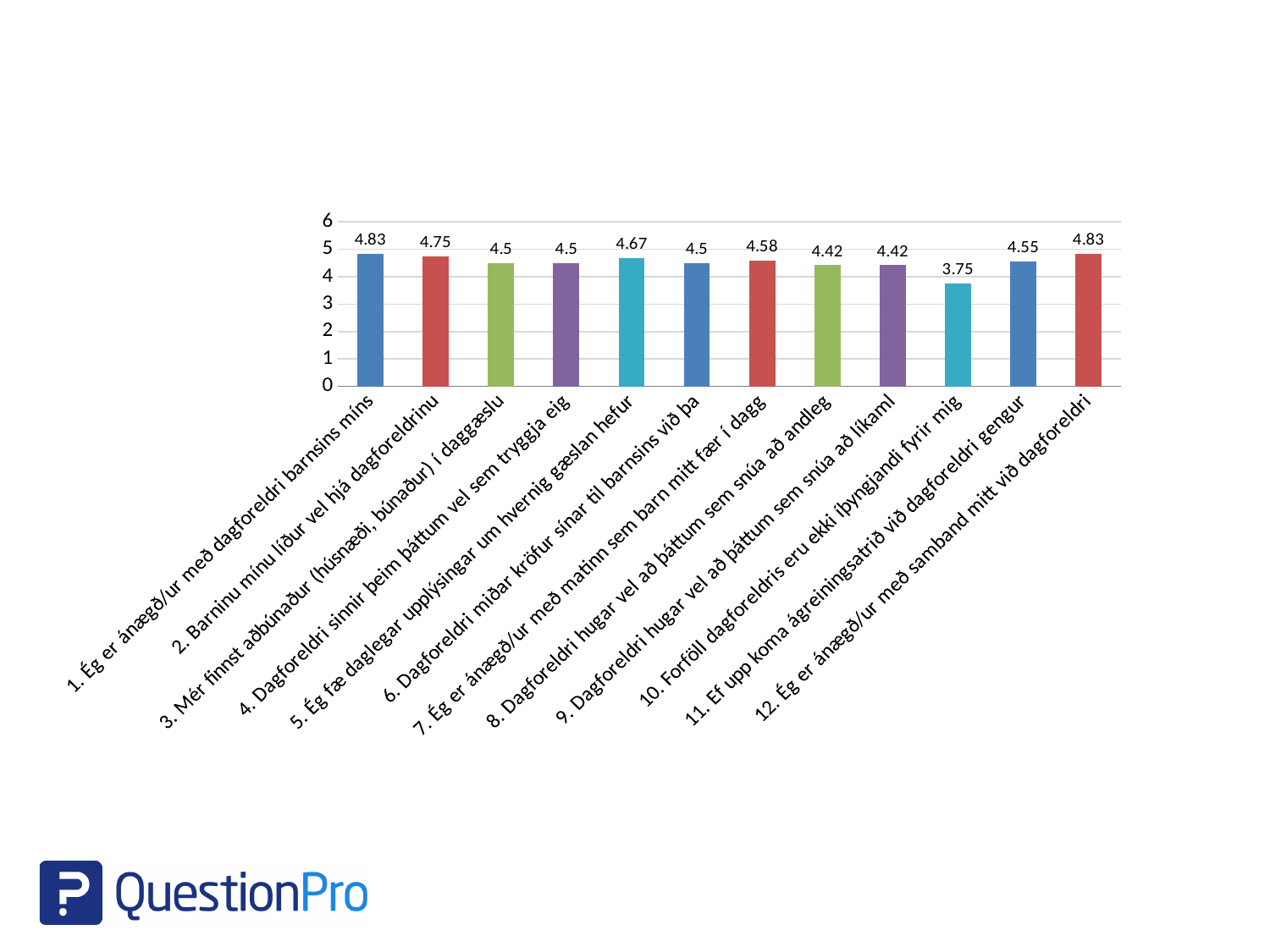
What kind of chart is shown on the slide? Bar chart What is the value for "11. Ef upp koma ágreiningsatriði við dagforeldri gengur"? 4.55 Is the value for item 10 greater or less than 4? less What is the value for "10. Forföll dagforeldris eru ekki íþyngjandi fyrir mig"? 3.75 Which category has the lowest value? 10. Forföll dagforeldris eru ekki íþyngjandi fyrir mig What is the highest value shown on the chart? 4.83 What is the value for "2. Barninu mínu líður vel hjá dagforeldrinu"? 4.75 How many categories (bars) are shown on the chart? 12 What is the value for "5. Ég fæ daglegar upplýsingar um hvernig gæslan hefur"? 4.67 Which is larger, the value for item 5 or the value for item 8? Item 5 What is the difference between the values for item 1 and item 10? 1.08 What is the difference between the values for item 2 and item 7? 0.17